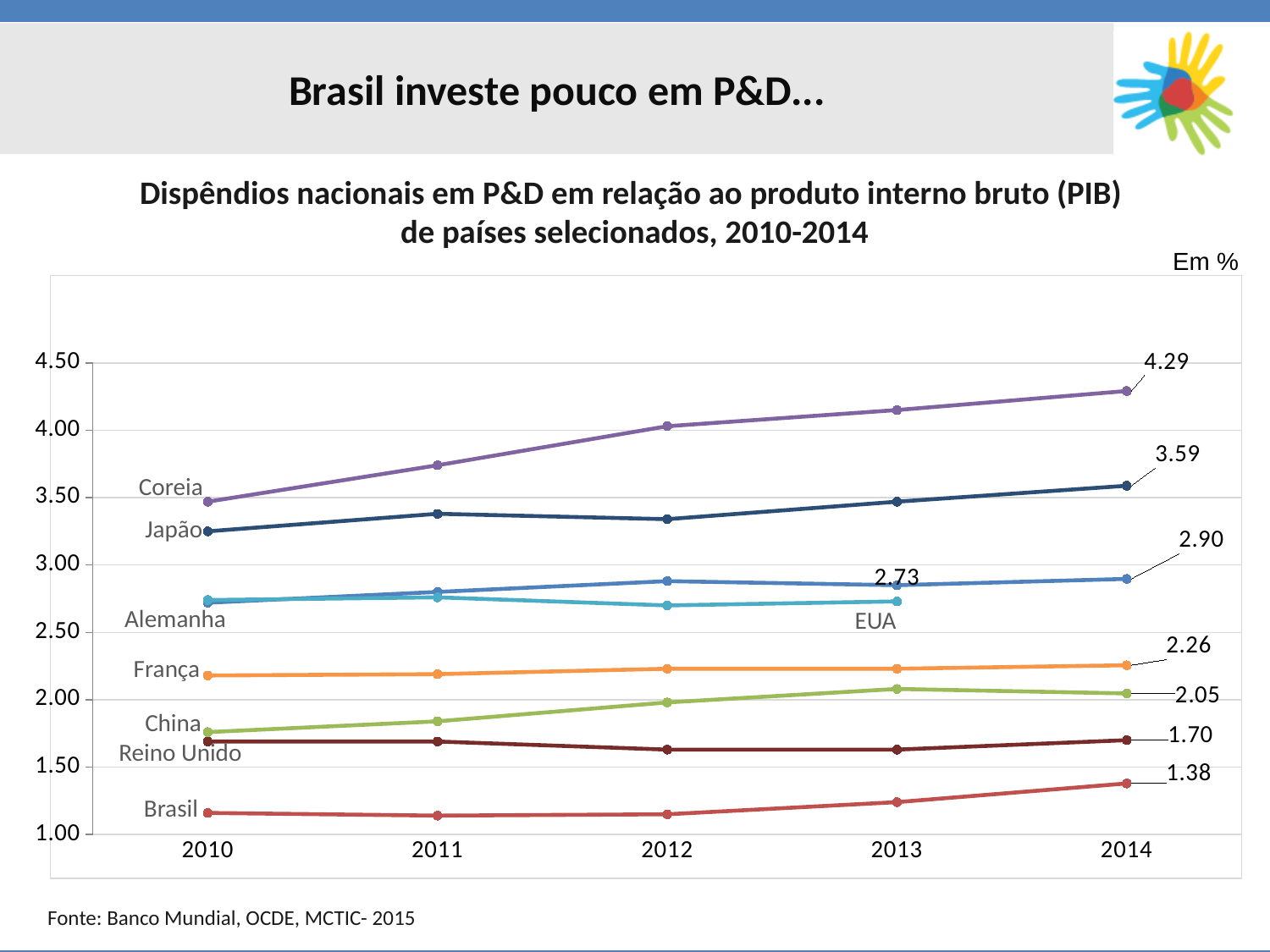
Which country has the lowest value in 2014? Brasil How many countries are plotted on the chart? 8 What is the value for Brasil in 2014? 1.38 Is the value for Brasil in 2010 greater or less than 1.50? less What is the value for EUA in 2013? 2.73 Which is larger in 2014, the value for França or the value for China? França Which country has the highest value in 2014? Coreia How many years are shown on the x axis? 5 What is the difference between the 2014 values for Coreia and Brasil? 2.91 What is the difference between the 2014 values for Japão and Alemanha? 0.69 What kind of chart is shown on the slide? line chart What is the value for Coreia in 2014? 4.29